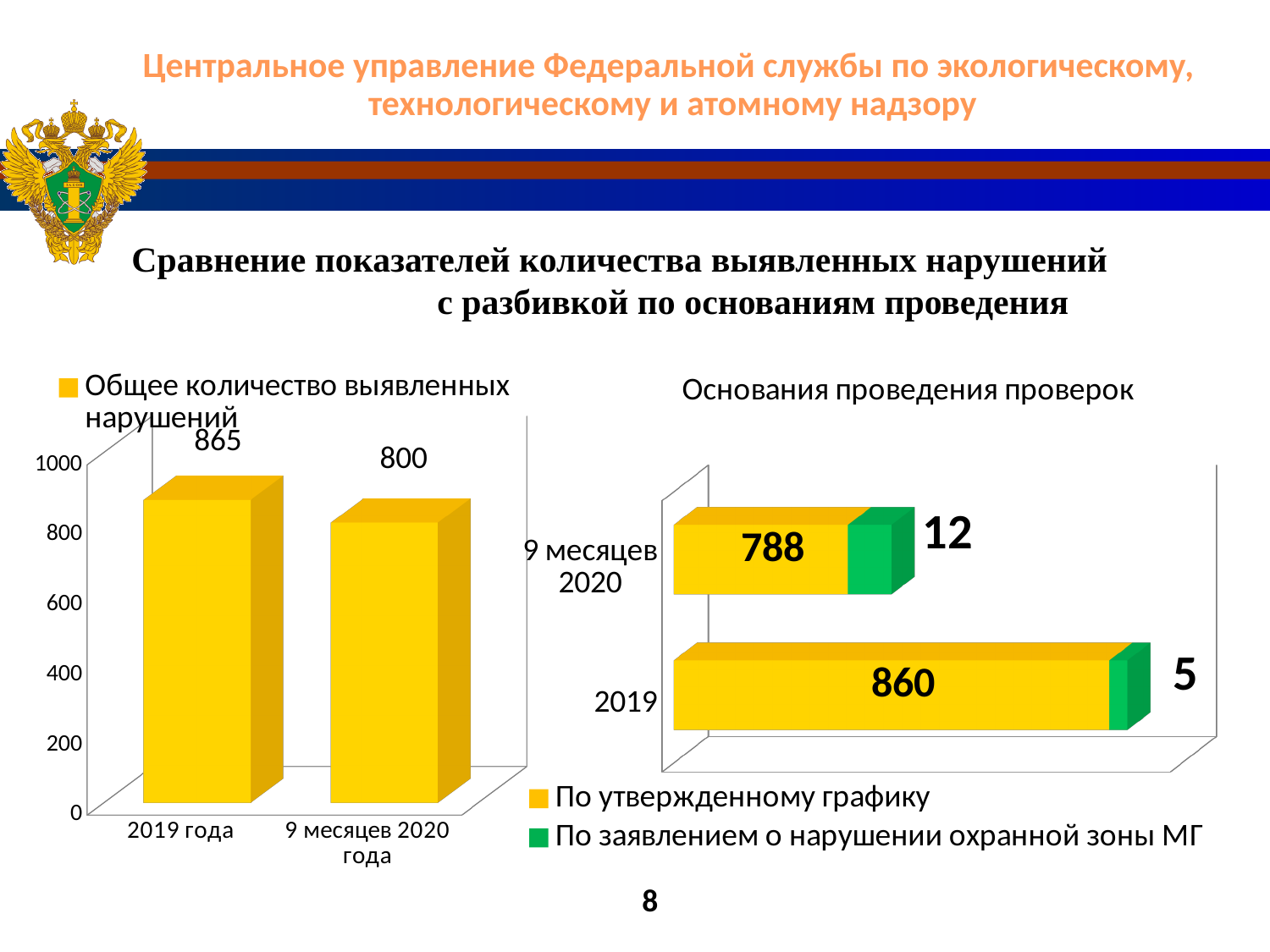
In the chart titled Основания проведения проверок, which year has the larger value for По заявлением о нарушении охранной зоны МГ, 2019 or 9 месяцев 2020? 9 месяцев 2020 In the chart titled Основания проведения проверок, what is the total of the stacked bar for 2019? 865 In the left chart, which category has the higher value? 2019 года In the chart titled Основания проведения проверок, what is the value for По утвержденному графику in 2019? 860 What kind of chart is the chart titled Основания проведения проверок? Stacked bar chart In the left chart, what is the value for 2019 года? 865 In the left chart, how many categories are shown on the x axis? 2 In the chart titled Основания проведения проверок, what is the total of the stacked bar for 9 месяцев 2020? 800 In the left chart, what is the difference between the values for 2019 года and 9 месяцев 2020 года? 65 In the chart titled Основания проведения проверок, what is the value for По заявлением о нарушении охранной зоны МГ in 9 месяцев 2020? 12 In the left chart, what is the value for 9 месяцев 2020 года? 800 In the chart titled Основания проведения проверок, how many series does the legend list? 2